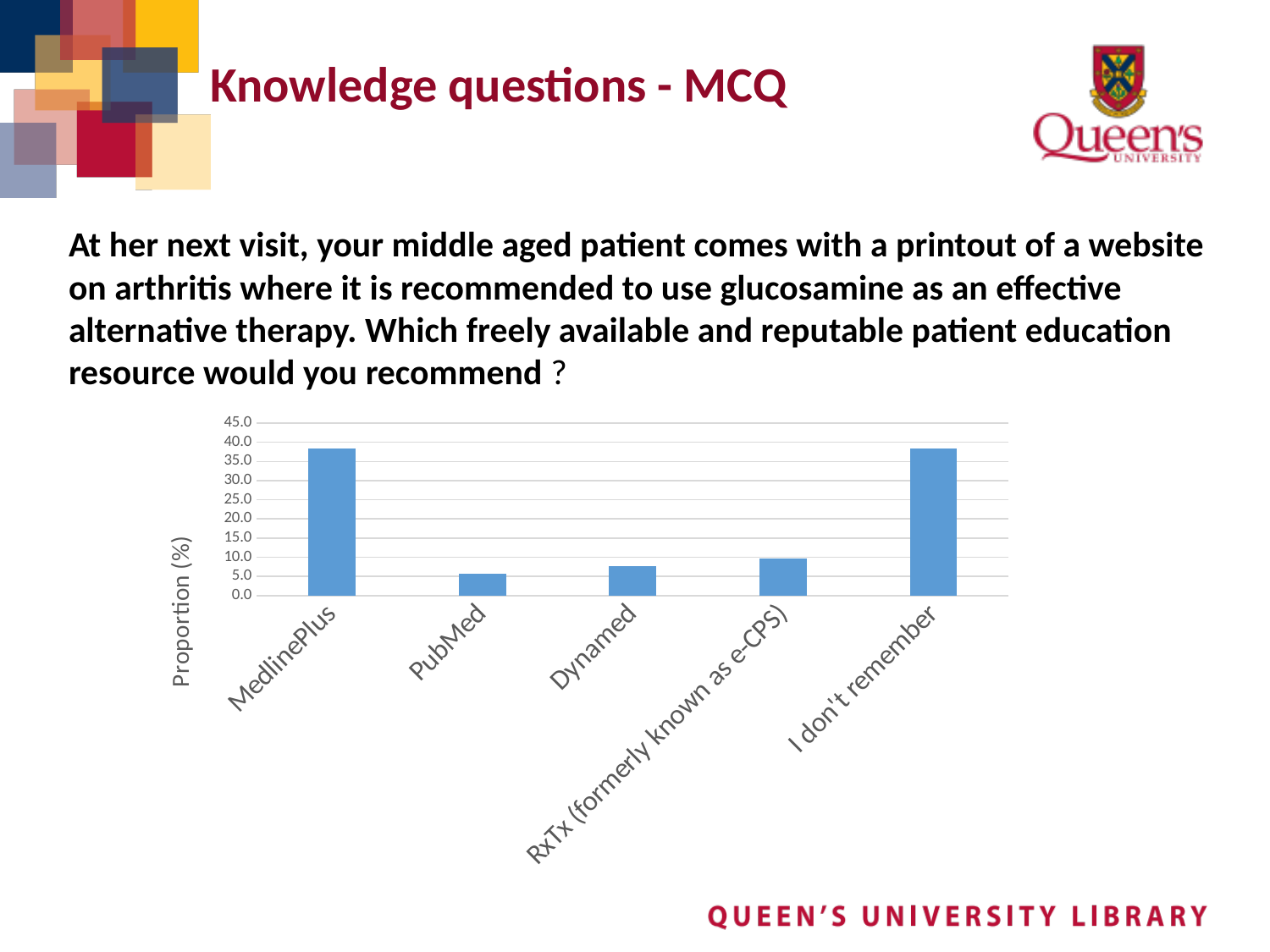
Is the value for MedlinePlus greater or less than 35? greater Is the value for Dynamed greater or less than 10? less Which category has the lowest value in the chart? PubMed Is the value for RxTx (formerly known as e-CPS) greater or less than 5? greater How many categories are shown on the x axis of the chart? 5 What is the label on the vertical axis of the chart? Proportion (%) Which is larger, the value for Dynamed or the value for PubMed? Dynamed What kind of chart is shown on the slide? bar chart Which is larger, the value for MedlinePlus or the value for RxTx (formerly known as e-CPS)? MedlinePlus